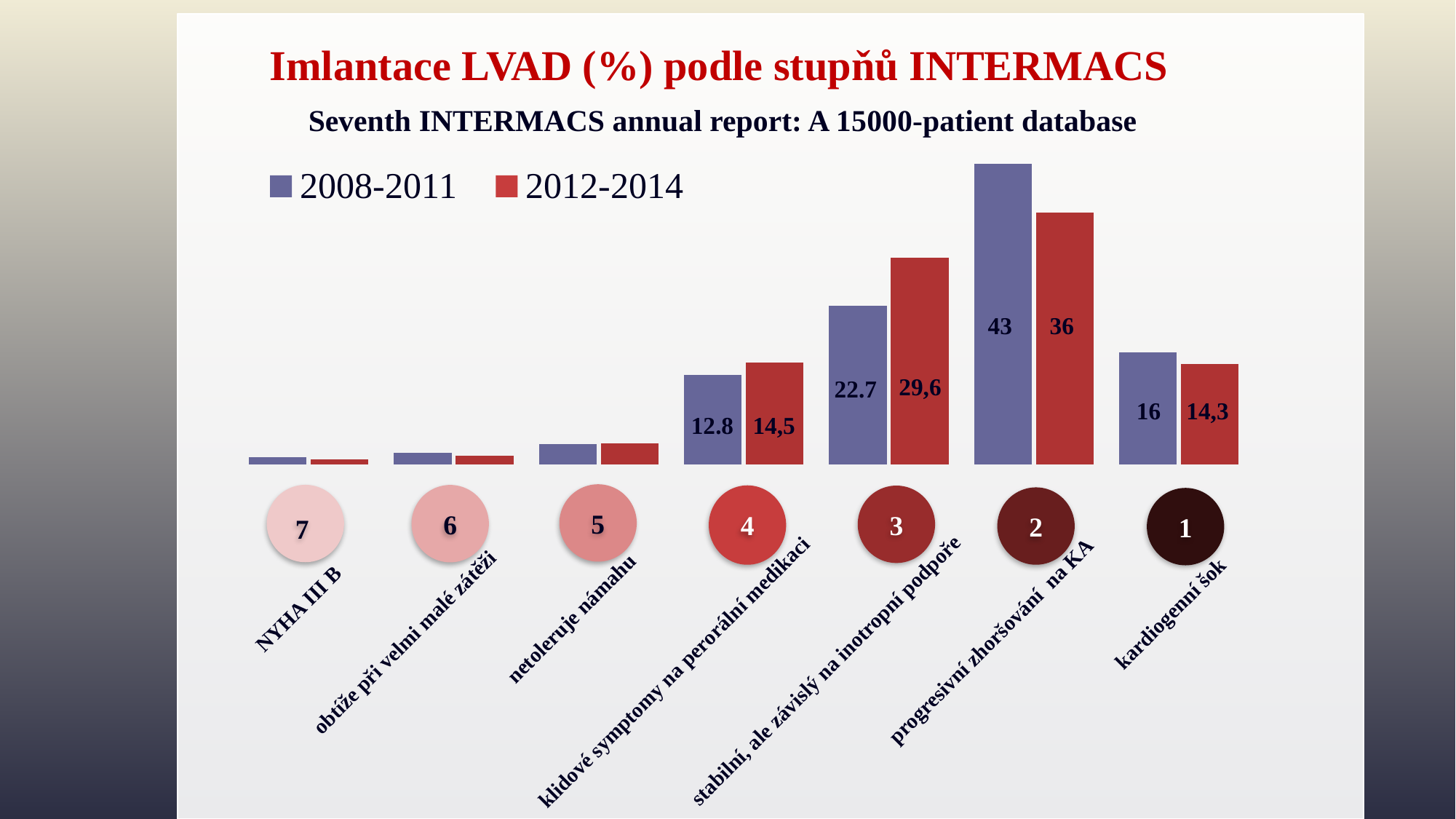
Which category has the highest 2008-2011 value? progresivní zhoršování na KA What is the 2012-2014 value for 'kardiogenní šok'? 14,3 What is the 2012-2014 value for 'stabilní, ale závislý na inotropní podpoře'? 29,6 What is the 2008-2011 value for 'klidové symptomy na perorální medikaci'? 12.8 What is the difference between the 2008-2011 and 2012-2014 values for 'progresivní zhoršování na KA'? 7 Which category has the lowest 2012-2014 value? NYHA III B What are the two series named in the legend? 2008-2011 and 2012-2014 What kind of chart is shown on the slide? bar chart What is the 2008-2011 value for 'progresivní zhoršování na KA'? 43 How many series does the legend list? 2 How many categories are shown along the x axis? 7 For 'stabilní, ale závislý na inotropní podpoře', which series has the larger value, 2008-2011 or 2012-2014? 2012-2014